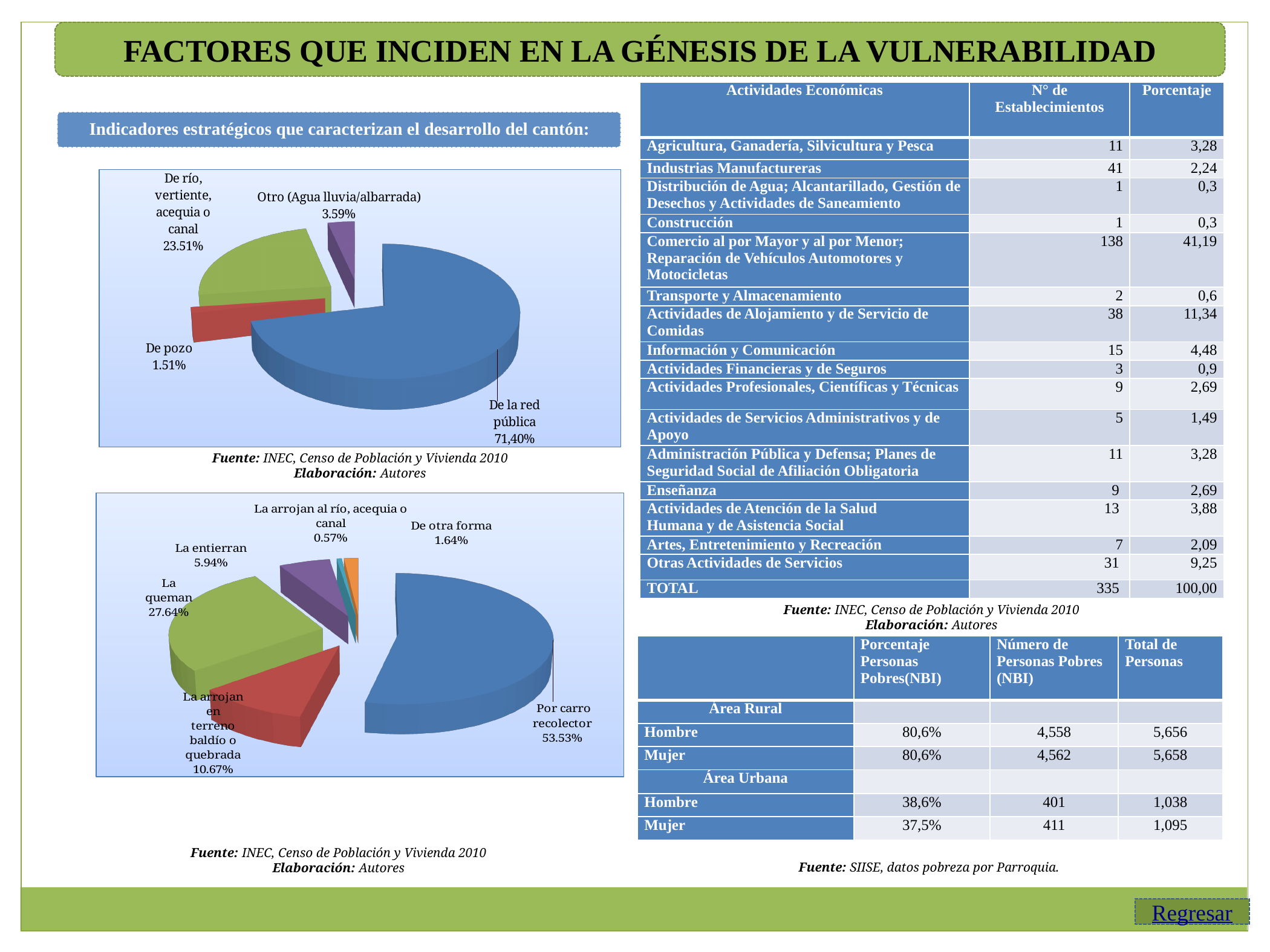
How many slices does the bottom-left pie chart have? 6 In the bottom-left pie chart, which is larger: 'La entierran' or 'La arrojan en terreno baldío o quebrada'? La arrojan en terreno baldío o quebrada In the top-left pie chart, what is the share for 'De pozo'? 1.51% In the bottom-left pie chart, what is the share for 'La queman'? 27.64% In the top-left pie chart, what is the difference between 'De río, vertiente, acequia o canal' and 'Otro (Agua lluvia/albarrada)'? 19.92% In the top-left pie chart, which category has the largest slice? De la red pública In the top-left pie chart, which category has the smallest slice? De pozo In the bottom-left pie chart, what is the share for 'Por carro recolector'? 53.53% How many slices does the top-left pie chart have? 4 In the bottom-left pie chart, which category has the smallest slice? La arrojan al río, acequia o canal What kind of chart is the bottom-left chart? Pie chart In the top-left pie chart, what is the share for 'De la red pública'? 71,40%